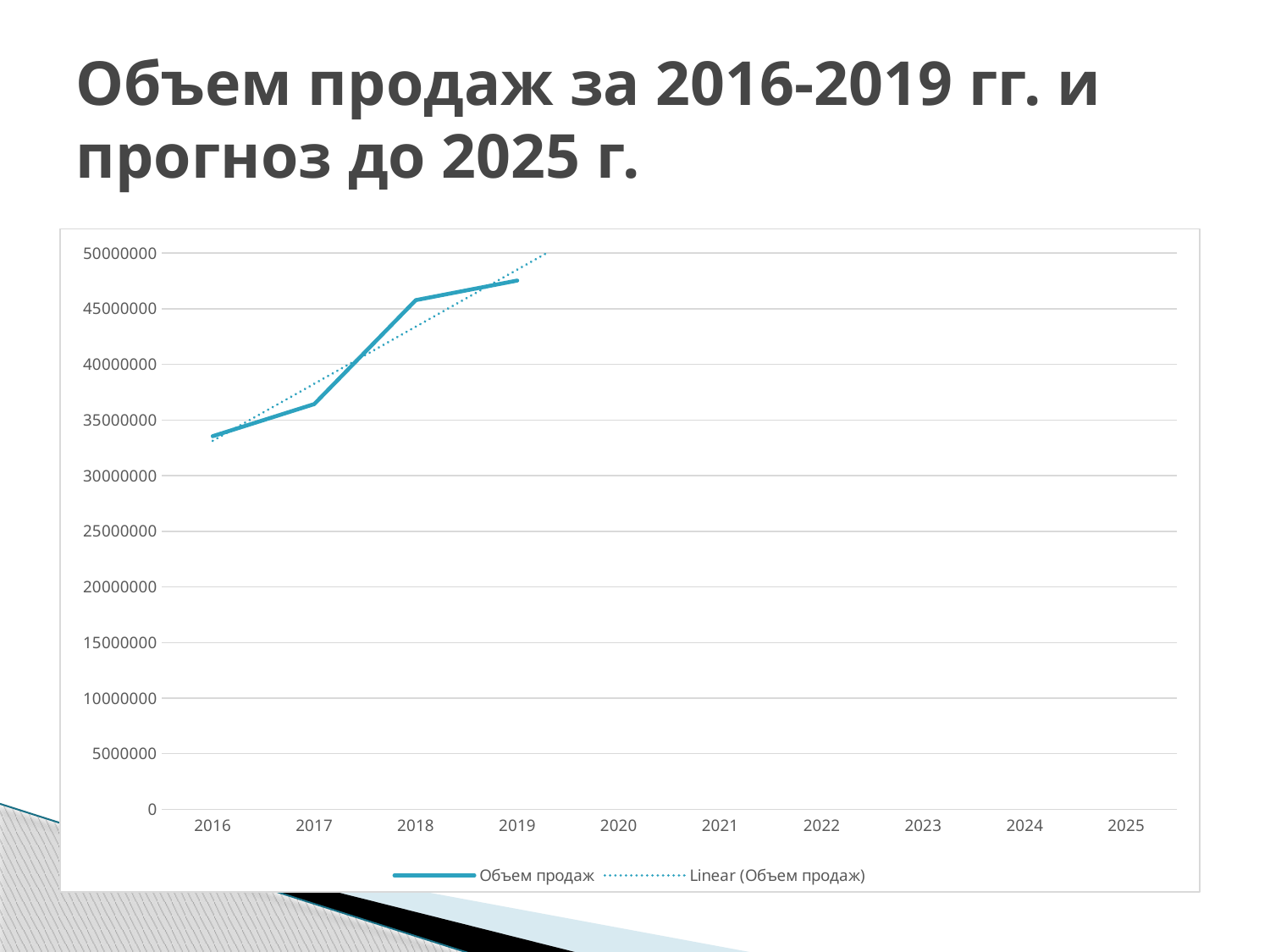
How many years are labelled on the x axis? 10 Which year has the highest value for Объем продаж? 2019 Which year has the lowest value for Объем продаж? 2016 Which year has the larger value for Объем продаж, 2017 or 2018? 2018 Is the value for Объем продаж in 2016 greater or less than 30000000? greater Is the value for Объем продаж in 2019 greater or less than 50000000? less How many entries does the legend list? 2 Is the value for Объем продаж in 2017 greater or less than 40000000? less Do the sales values rise or fall from 2016 to 2019? rise What is the name of the dotted trendline entry in the legend? Linear (Объем продаж) What kind of chart is shown on the slide? line chart